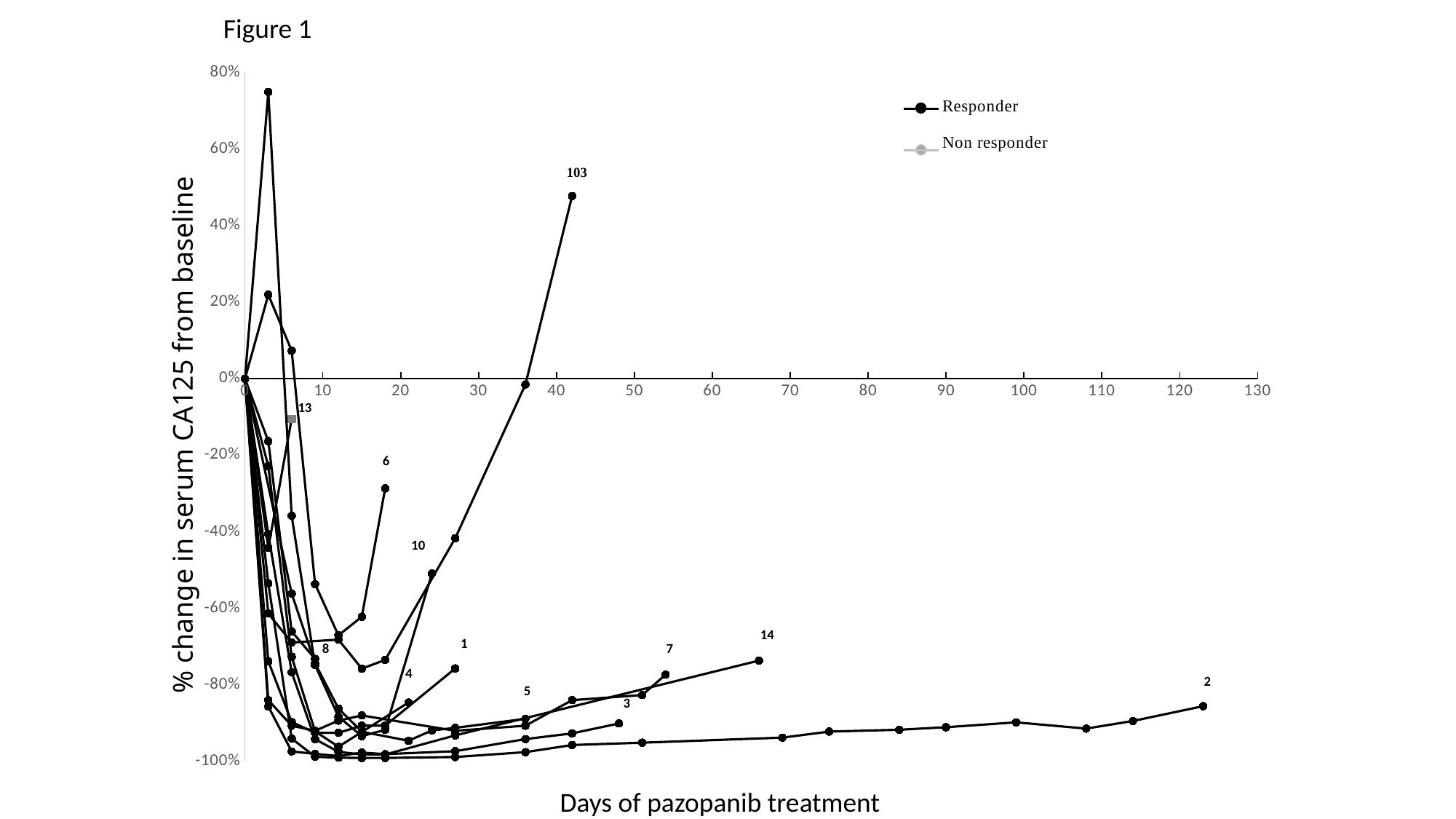
Is the value for patient 13 (Non responder) greater or less than -20%? greater Is the final value for patient 14 greater or less than -60%? less Is the final value for patient 2 greater or less than -80%? less Which labelled patient's line extends furthest along the x axis (most days of treatment)? 2 What is the title of the chart? Figure 1 Which is higher at its final point: patient 6 or patient 10? Patient 6 Which labelled patient ends with the highest % change in serum CA125 from baseline? 103 What kind of chart is shown on the slide? Line chart What are the two entries in the chart legend? Responder and Non responder How many series does the legend list? 2